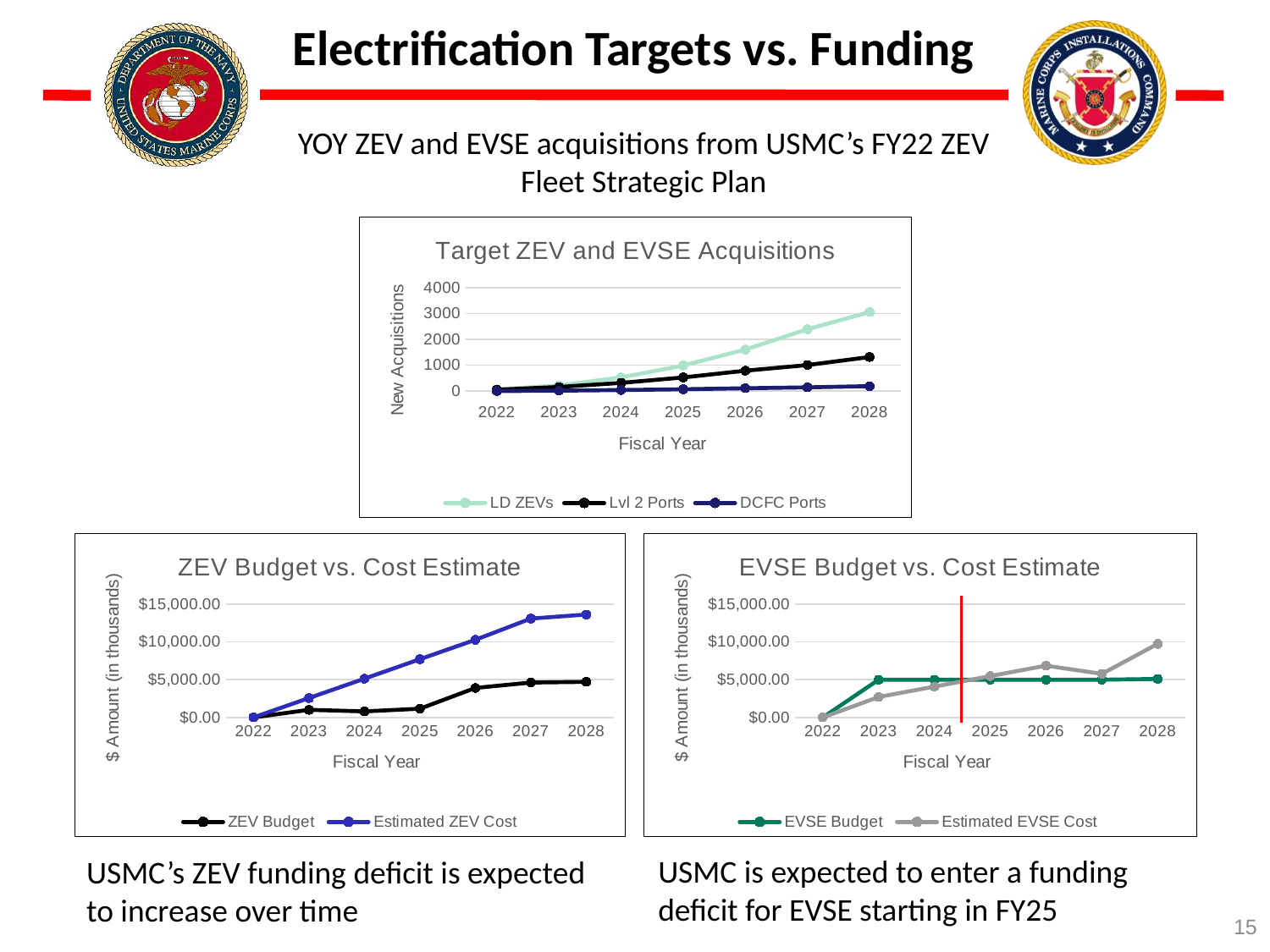
What is the x-axis title of the 'EVSE Budget vs. Cost Estimate' chart? Fiscal Year What type of chart is the 'Target ZEV and EVSE Acquisitions' chart? line chart In the 'ZEV Budget vs. Cost Estimate' chart, which series is larger in 2027, ZEV Budget or Estimated ZEV Cost? Estimated ZEV Cost In the 'Target ZEV and EVSE Acquisitions' chart, is the value for LD ZEVs in 2028 greater or less than 2000? greater In the 'Target ZEV and EVSE Acquisitions' chart, is the value for DCFC Ports in 2028 greater or less than 1000? less In the 'Target ZEV and EVSE Acquisitions' chart, which series has the highest value in 2028? LD ZEVs In the 'ZEV Budget vs. Cost Estimate' chart, does the Estimated ZEV Cost rise or fall from 2022 to 2028? rise In the 'Target ZEV and EVSE Acquisitions' chart, how many fiscal years are shown on the x axis? 7 How many series does the legend of the 'Target ZEV and EVSE Acquisitions' chart list? 3 In the 'ZEV Budget vs. Cost Estimate' chart, is the Estimated ZEV Cost in 2028 greater or less than $10,000.00? greater How many series does the legend of the 'EVSE Budget vs. Cost Estimate' chart list? 2